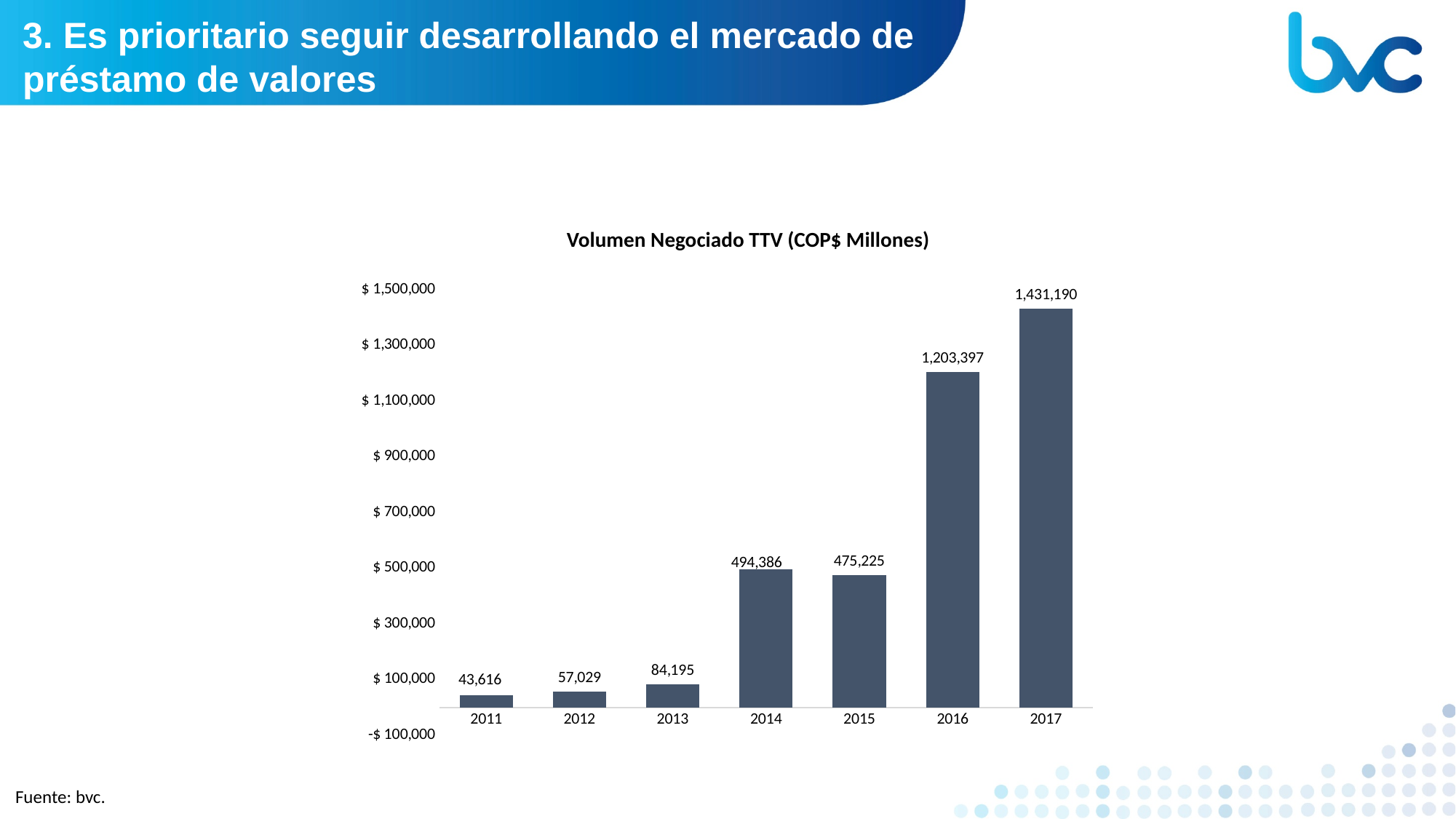
What is the value for 2014 in the chart? 494,386 What kind of chart is shown on the slide? Bar chart What is the difference between the values for 2017 and 2016? 227,793 Which year has the larger value, 2014 or 2015? 2014 What is the title of the chart? Volumen Negociado TTV (COP$ Millones) Which year has the lowest value in the chart? 2011 What is the value for 2011 in the chart? 43,616 What is the difference between the values for 2014 and 2015? 19,161 What is the value for 2017 in the chart? 1,431,190 Which year has the highest value in the chart? 2017 Is the value for 2016 greater or less than $ 1,100,000? greater How many years are shown on the x axis of the chart? 7